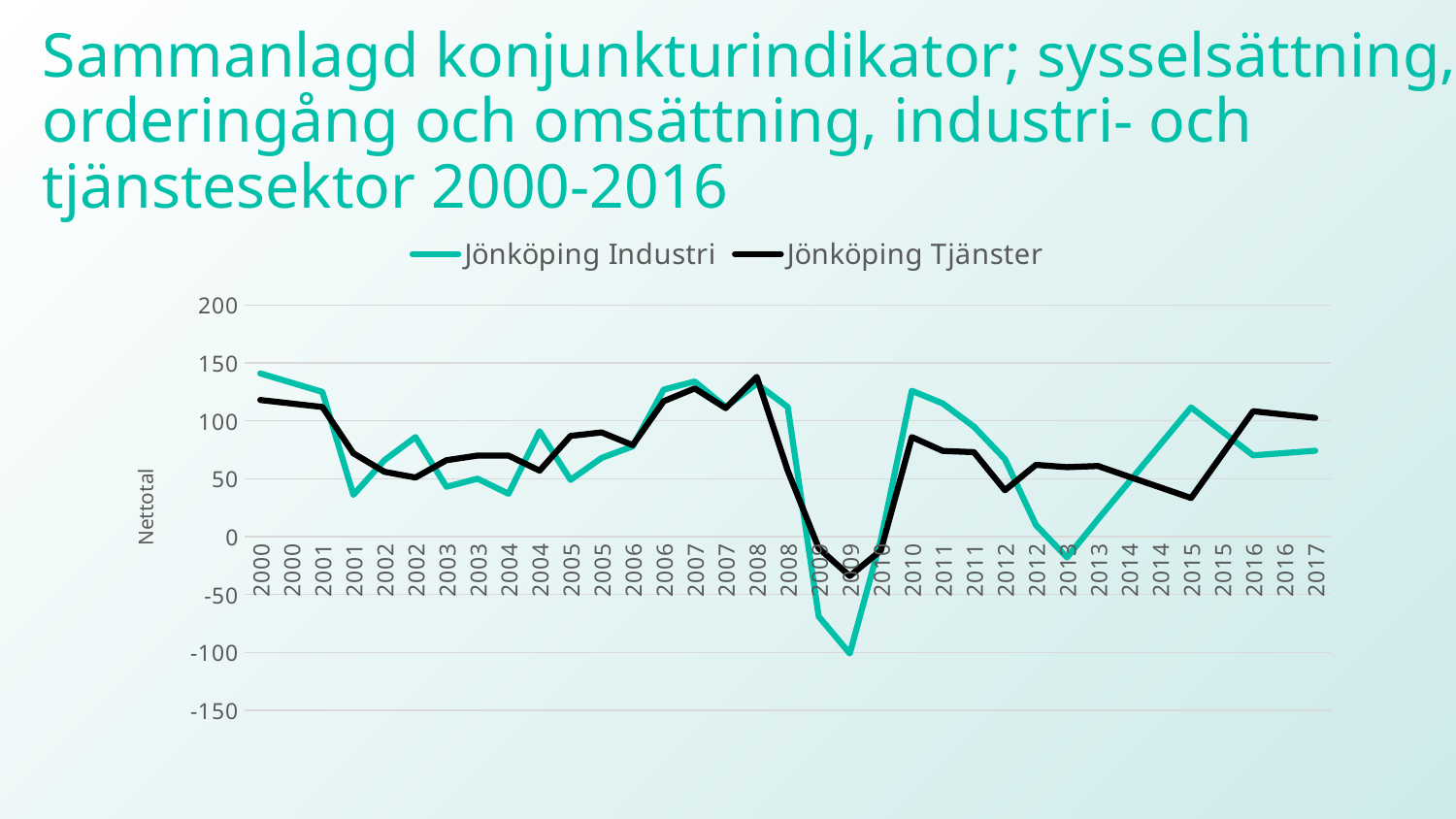
At the first 2015 point, which series has the higher value, Jönköping Industri or Jönköping Tjänster? Jönköping Industri Does the Jönköping Industri series rise or fall between the first 2008 point and the second 2009 point? fall What are the two series named in the legend? Jönköping Industri and Jönköping Tjänster Is the value for Jönköping Industri at the second 2009 point greater or less than -50? less Is the value for Jönköping Tjänster at the first 2015 point greater or less than 50? less What kind of chart is shown on the slide? line chart What is the label on the vertical axis? Nettotal Is the value for Jönköping Industri at the first 2000 point greater or less than 100? greater At the second 2009 point, which series has the higher value, Jönköping Industri or Jönköping Tjänster? Jönköping Tjänster In which year does the Jönköping Industri series reach its lowest value? 2009 How many series does the legend list? 2